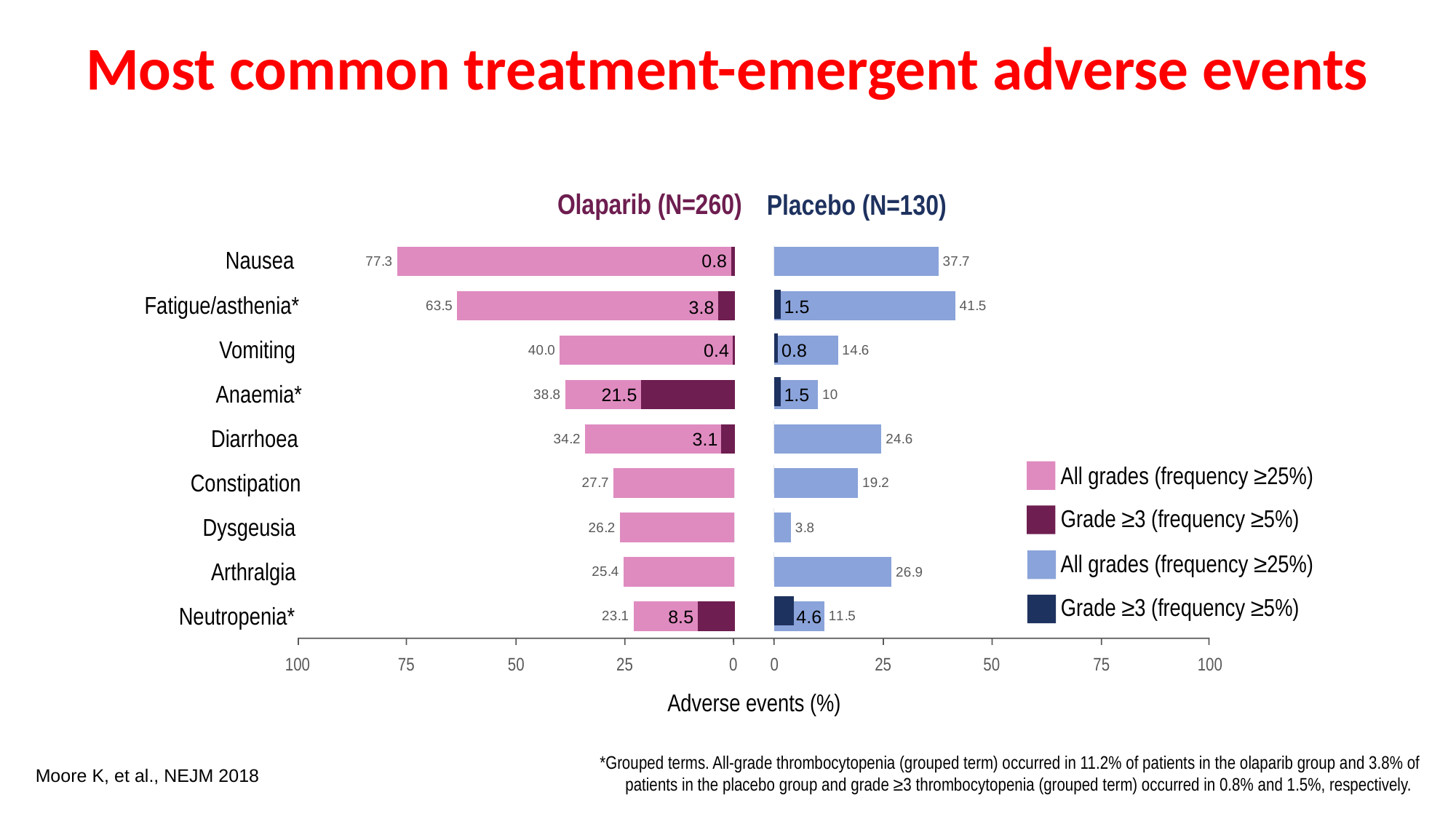
Which is larger: the all-grade frequency of arthralgia in the olaparib group or in the placebo group? Placebo What is the grade ≥3 frequency of neutropenia in the placebo group? 4.6 Which adverse event has the lowest all-grade frequency in the placebo group? Dysgeusia What is the all-grade frequency of fatigue/asthenia in the placebo group? 41.5 What kind of chart is shown on the slide? Bar chart How many adverse events are listed on the chart? 9 How many entries does the legend list? 4 What is the grade ≥3 frequency of anaemia in the olaparib group? 21.5 What is the all-grade frequency of nausea in the olaparib group? 77.3 Which adverse event has the highest all-grade frequency in the olaparib group? Nausea What is the difference between the all-grade frequency of nausea in the olaparib group and in the placebo group? 39.6 What is the label of the x axis? Adverse events (%)